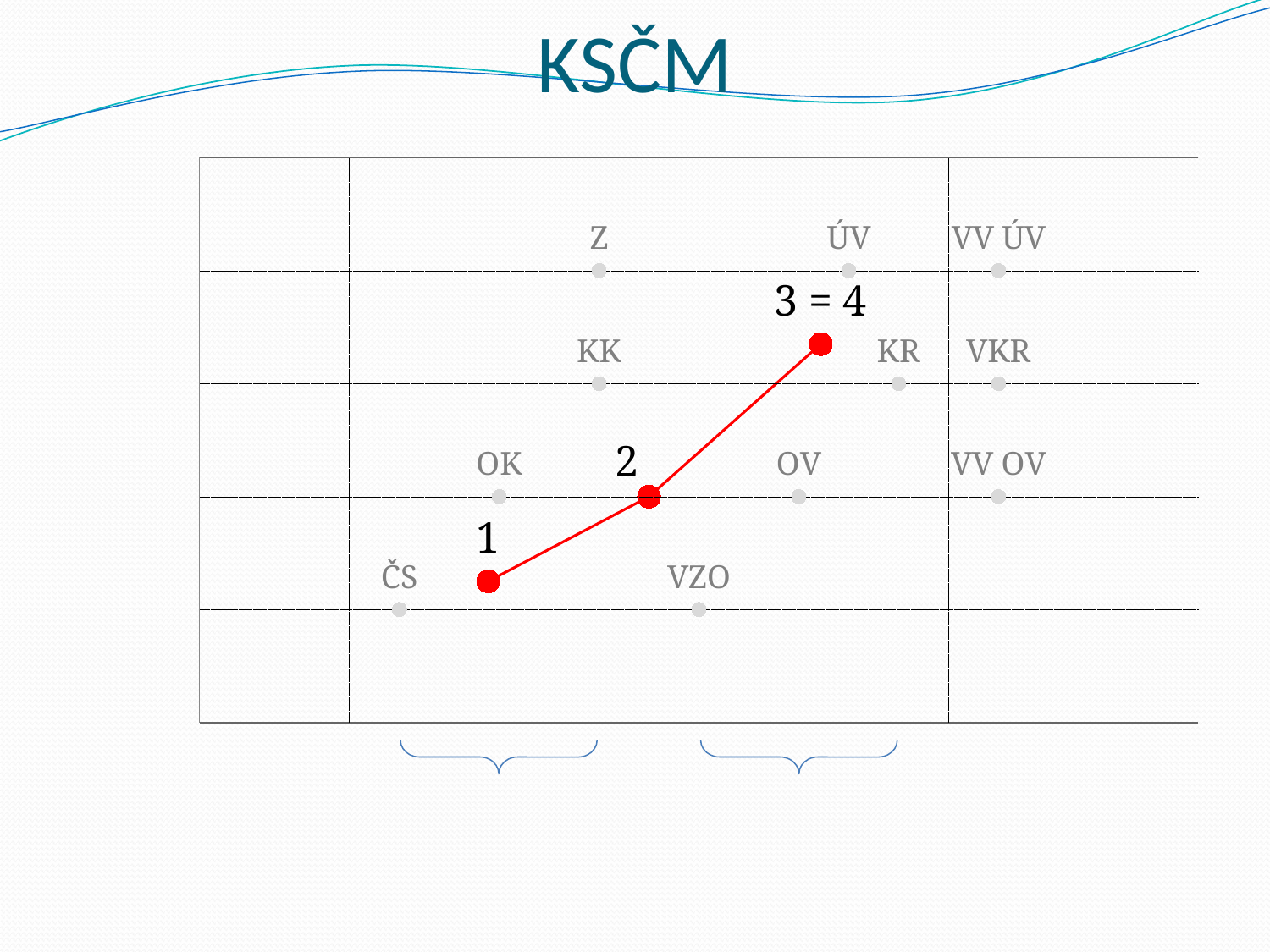
Which red point is positioned higher, point 2 or point 3 = 4? 3 = 4 What is the title of the chart on the slide? KSČM Does the red line rise or fall from left to right? rise Which red point is positioned higher, point 1 or point 2? 2 Which red point is positioned lowest on the chart? 1 What are the labels of the three red points, from left to right? 1, 2, 3 = 4 How many gray labelled points are shown on the chart? 11 What kind of chart is shown on the slide? line chart How many red points are connected by the red line? 3 Which gray labelled point lies on the same horizontal line as ÚV and VV ÚV? Z Which gray labelled point is the leftmost on the chart? ČS Which red point is positioned highest on the chart? 3 = 4